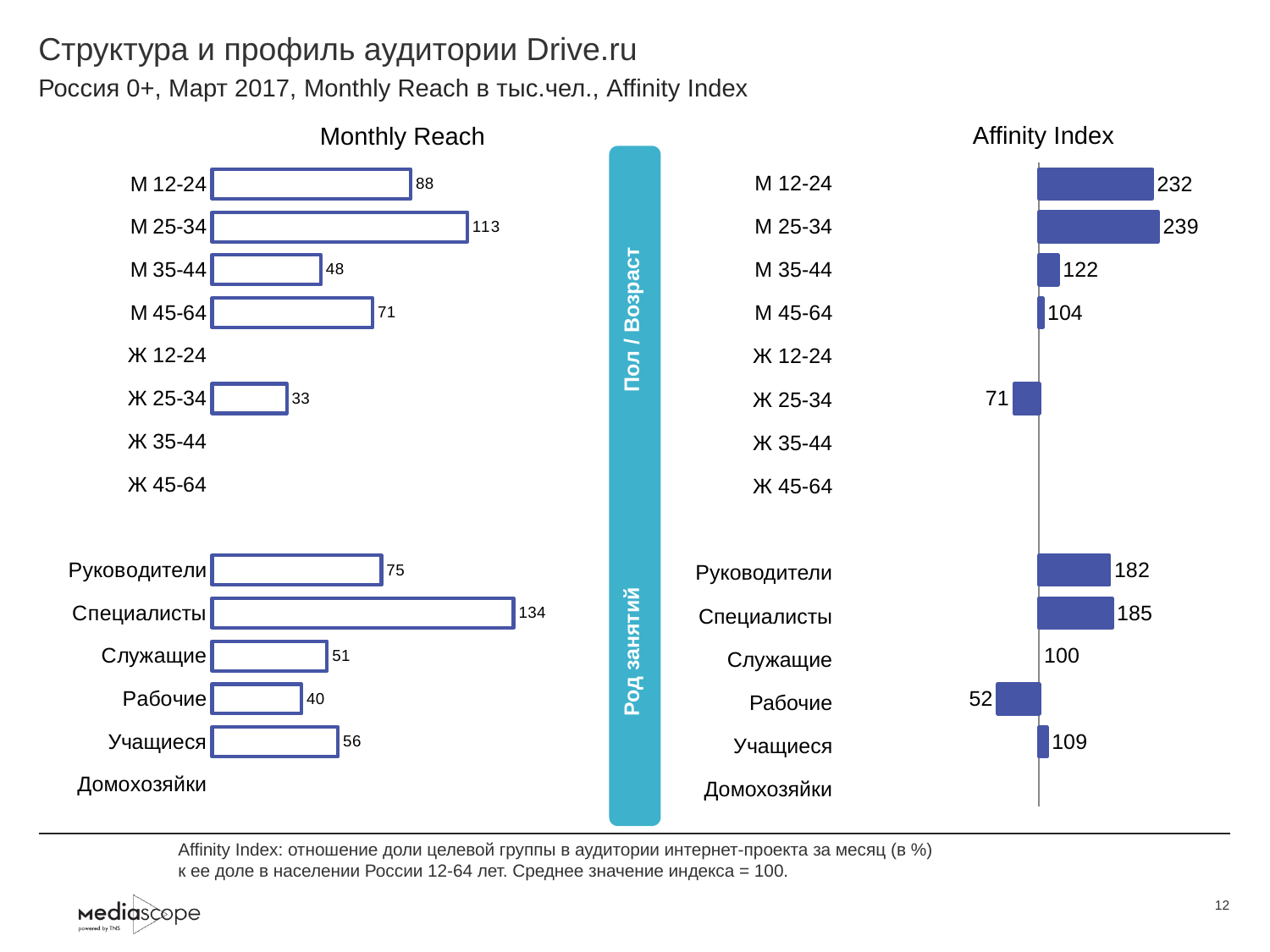
On the Affinity Index chart, which is larger: the value for М 12-24 or the value for М 25-34? М 25-34 On the Monthly Reach chart, which category has the highest value? Специалисты On the Monthly Reach chart, what is the difference between the values for Специалисты and Руководители? 59 What is the title of the chart on the left side of the slide? Monthly Reach What kind of chart is the Affinity Index chart? Bar chart On the Affinity Index chart, what is the difference between the values for Специалисты and Руководители? 3 On the Affinity Index chart, what is the value for Рабочие? 52 On the Monthly Reach chart, what is the value for М 25-34? 113 On the Monthly Reach chart, which is larger: the value for М 45-64 or the value for Ж 25-34? М 45-64 On the Affinity Index chart, which category has the lowest value among those with a printed value? Рабочие On the Monthly Reach chart, what is the value for Учащиеся? 56 On the Affinity Index chart, what is the value for Служащие? 100